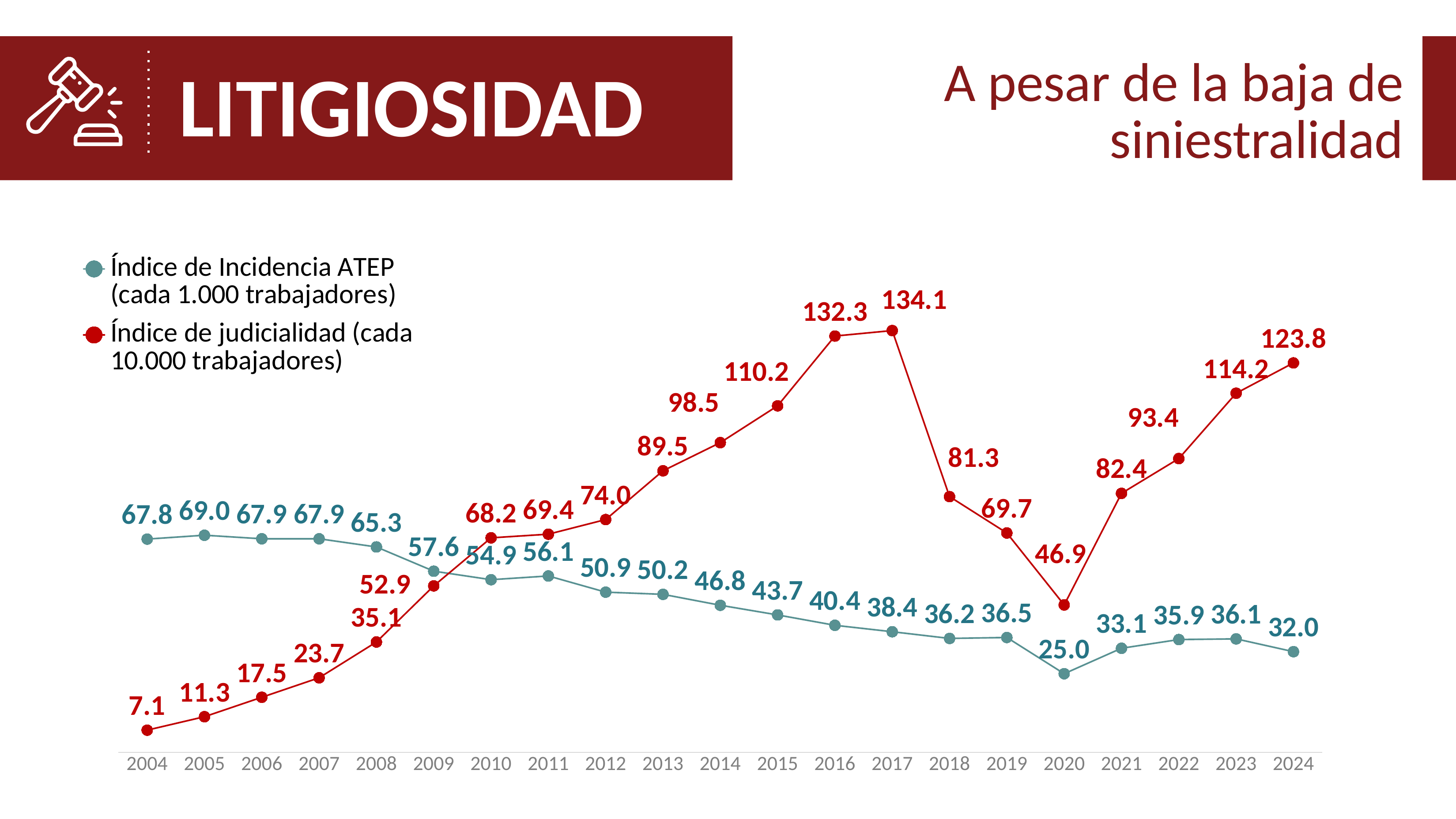
What colour is the line for the Índice de judicialidad? Red What is the value of the Índice de Incidencia ATEP in 2020? 25.0 By how much did the Índice de judicialidad increase from 2004 to 2024? 116.7 What is the value of the Índice de judicialidad in 2017? 134.1 In 2012, which series has the larger value, Índice de Incidencia ATEP or Índice de judicialidad? Índice de judicialidad By how much did the Índice de Incidencia ATEP fall from 2004 to 2024? 35.8 In which year does the Índice de judicialidad reach its highest value? 2017 In which year is the Índice de Incidencia ATEP at its lowest? 2020 Does the Índice de Incidencia ATEP generally rise or fall from 2004 to 2024? Fall What kind of chart is shown on the slide? Line chart How many series does the legend list? 2 How many years are plotted on the x axis? 21